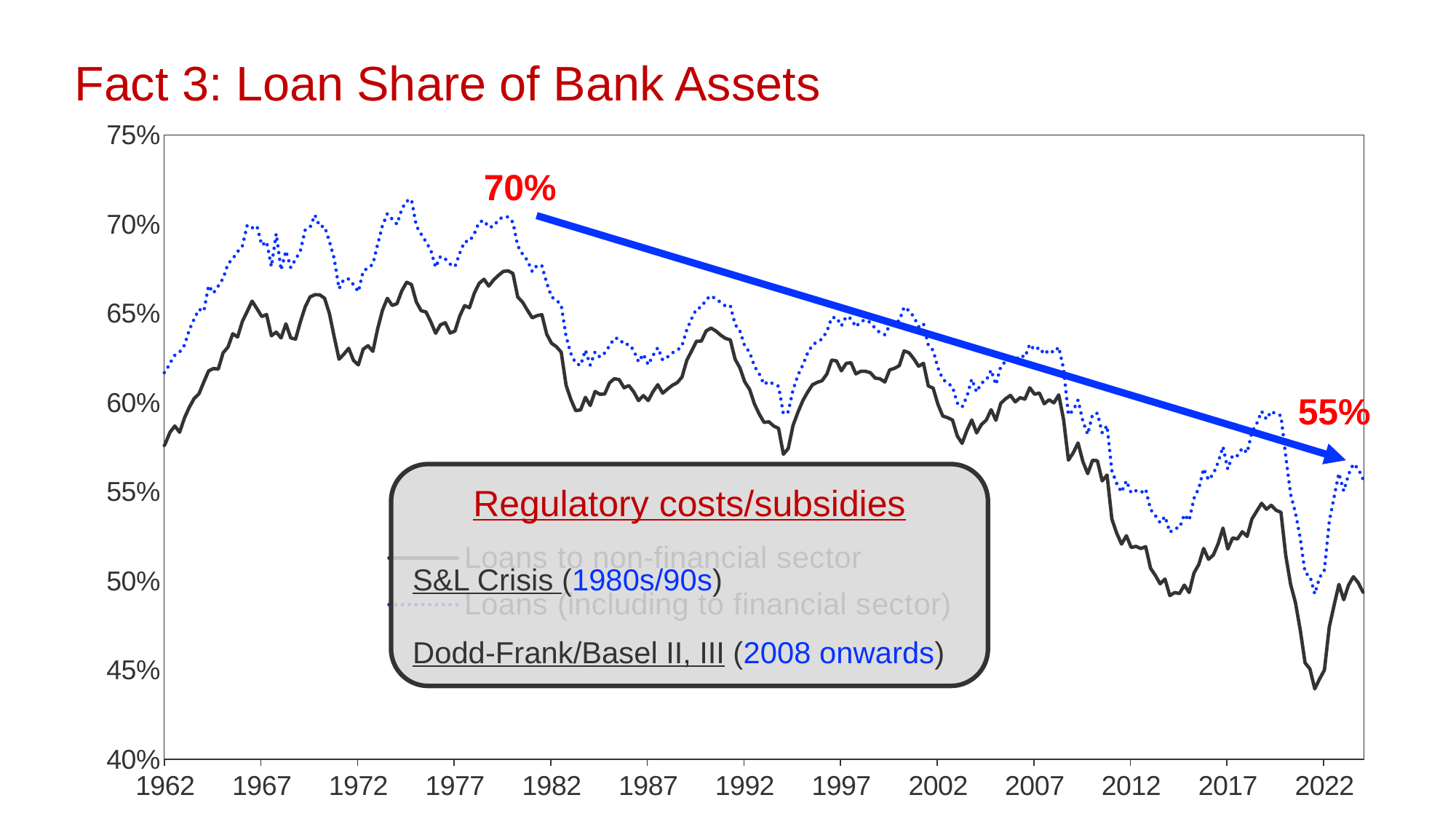
Is the value of the Loans to non-financial sector series around 2012 greater or less than 55%? less Which series is drawn as a dotted blue line? Loans (including to financial sector) Overall, do the plotted loan shares rise or fall from 1962 to 2022? fall In 1962, which series has the higher value: Loans to non-financial sector or Loans (including to financial sector)? Loans (including to financial sector) How many year labels are shown on the x axis? 13 Is the value of the Loans to non-financial sector series around 1980 greater or less than 65%? greater What is the title of the slide's chart? Fact 3: Loan Share of Bank Assets How many series does the chart's legend list? 2 Is the value of the Loans to non-financial sector series in 1962 greater or less than 60%? less What kind of chart is shown on the slide? line chart